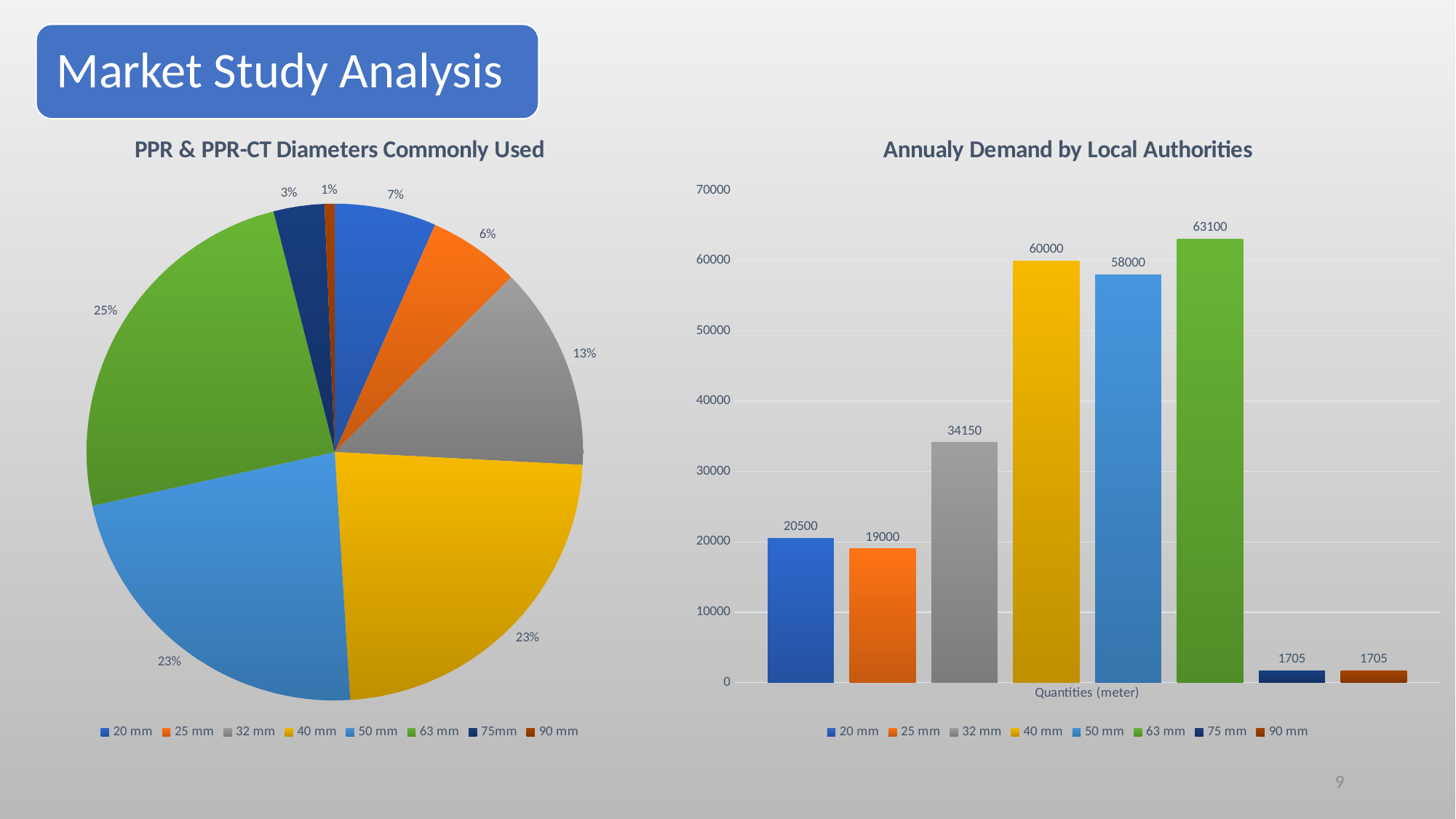
In the 'PPR & PPR-CT Diameters Commonly Used' pie chart, what share does 32 mm have? 13% In the 'Annualy Demand by Local Authorities' chart, which is larger, the value for 20 mm or the value for 25 mm? 20 mm In the 'Annualy Demand by Local Authorities' chart, which diameter has the highest demand? 63 mm In the 'PPR & PPR-CT Diameters Commonly Used' pie chart, which diameter has the smallest share? 90 mm In the 'Annualy Demand by Local Authorities' chart, what is the difference between the values for 40 mm and 50 mm? 2000 How many entries does the legend of the 'PPR & PPR-CT Diameters Commonly Used' pie chart list? 8 In the 'Annualy Demand by Local Authorities' chart, what is the value for 32 mm? 34150 In the 'Annualy Demand by Local Authorities' chart, what is the value for 40 mm? 60000 What kind of chart is 'Annualy Demand by Local Authorities'? Bar chart What is the x-axis label of the 'Annualy Demand by Local Authorities' chart? Quantities (meter) In the 'Annualy Demand by Local Authorities' chart, how many bars are plotted? 8 In the 'PPR & PPR-CT Diameters Commonly Used' pie chart, what share does 63 mm have? 25%